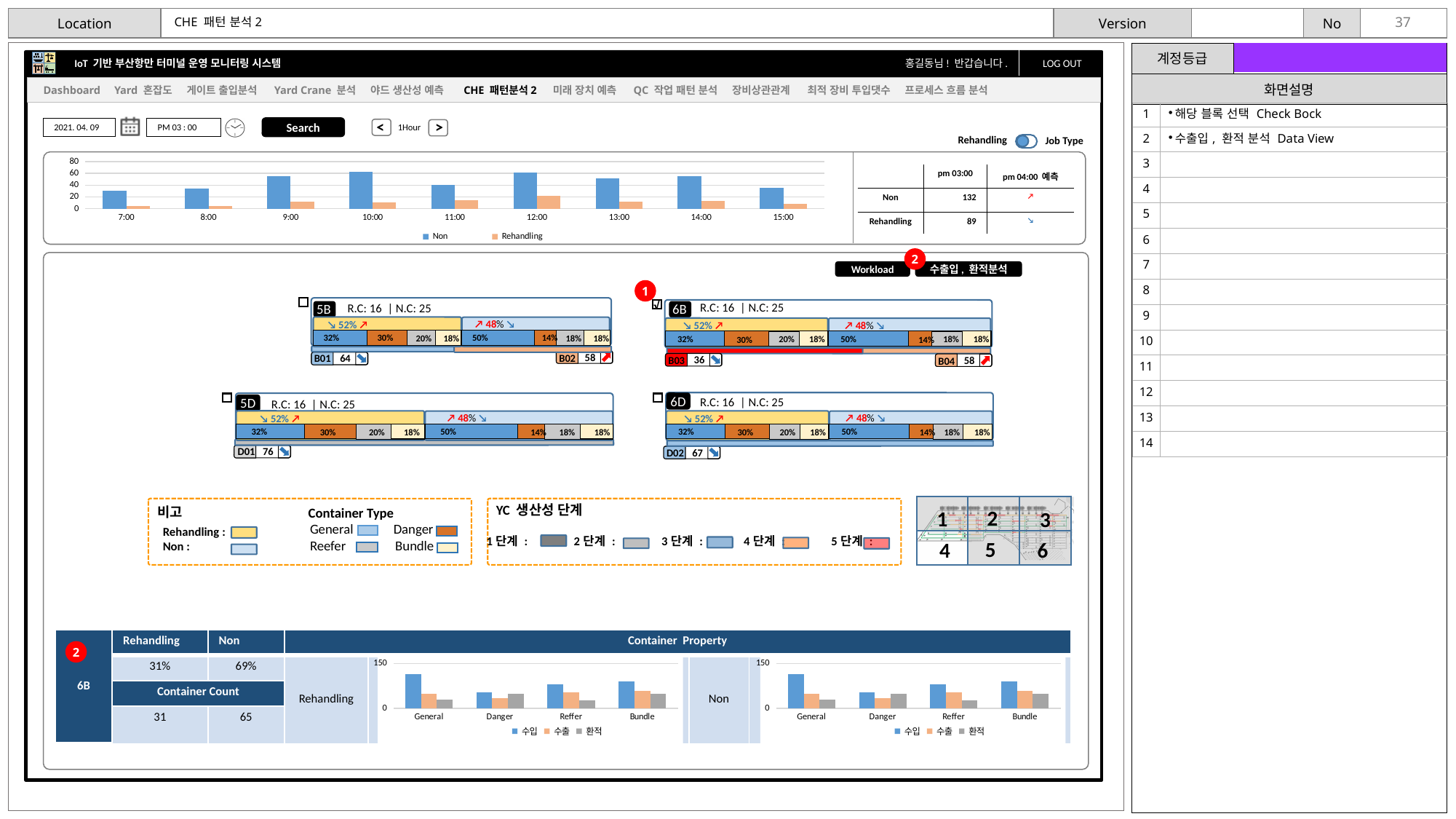
In the top Non/Rehandling chart, which is larger at 9:00, Non or Rehandling? Non How many series does the legend list in the bottom Rehandling Container Property chart? 3 What type of chart is the top chart showing Non and Rehandling by hour? bar chart In the top Non/Rehandling chart, is the Rehandling value at 7:00 greater or less than 20? less In the bottom Rehandling Container Property chart, which is larger for General, 수입 or 수출? 수입 In the top Non/Rehandling chart, at which hour is the Non value highest? 10:00 How many series does the legend of the top Non/Rehandling chart list? 2 In the top Non/Rehandling chart, is the Non value at 7:00 greater or less than 40? less In the top Non/Rehandling chart, at which hour is the Rehandling value highest? 12:00 How many time categories are shown on the x axis of the top Non/Rehandling chart? 9 How many categories are on the x axis of the bottom Non Container Property chart? 4 In the top Non/Rehandling chart, is the Non value at 10:00 greater or less than 40? greater